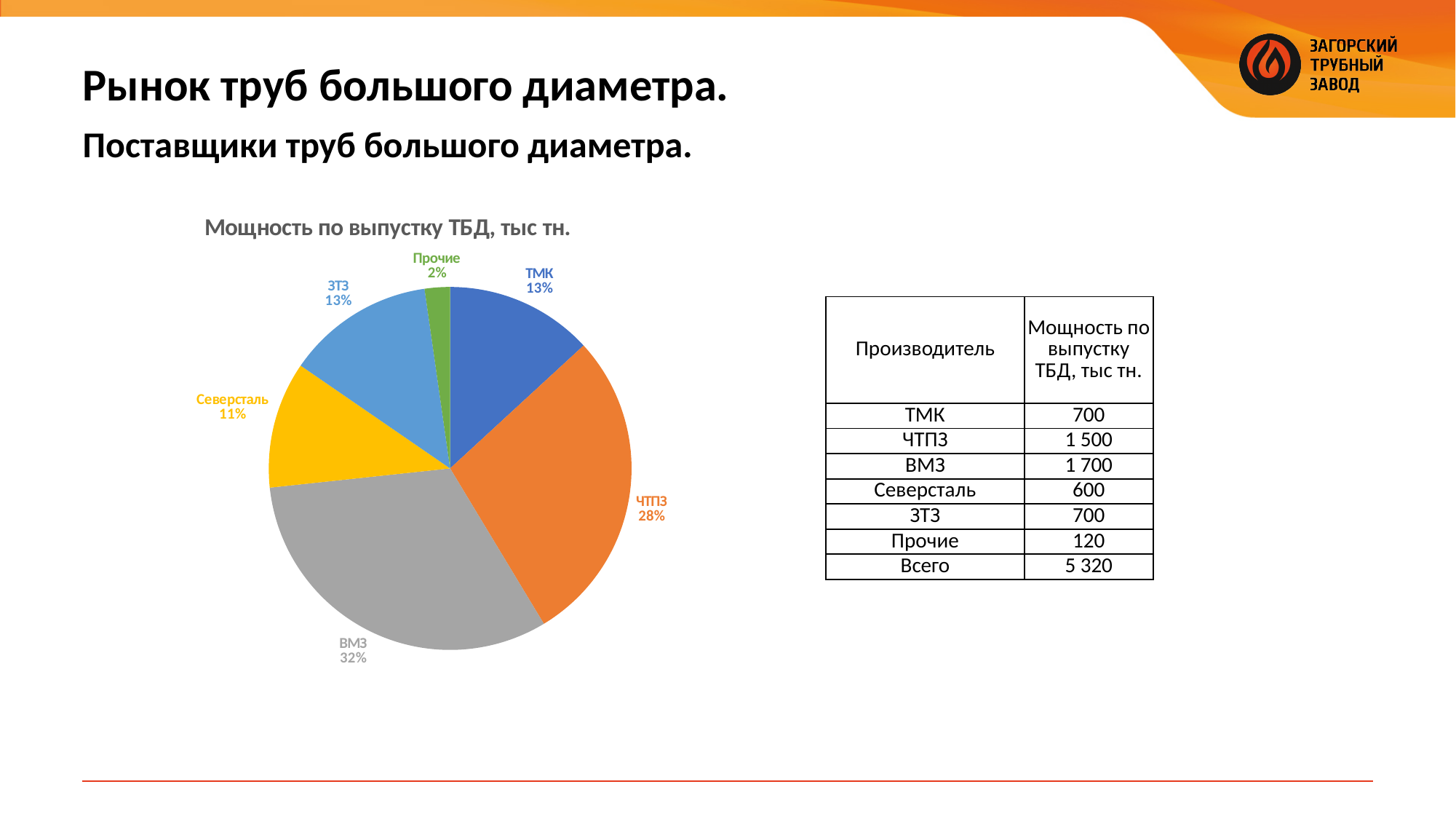
What is the title of the pie chart? Мощность по выпуску ТБД, тыс тн. What share of the pie does ВМЗ hold? 32% Which category has the largest slice of the pie? ВМЗ What type of chart is shown on the slide? pie chart What colour is the ВМЗ slice in the pie chart? grey What share of the pie does ЧТПЗ hold? 28% Which slice is larger, ЧТПЗ or Северсталь? ЧТПЗ What is the difference in percentage points between the ВМЗ and ЧТПЗ slices? 4 What share of the pie does Северсталь hold? 11% How many slices does the pie chart have? 6 Which category has the smallest slice of the pie? Прочие